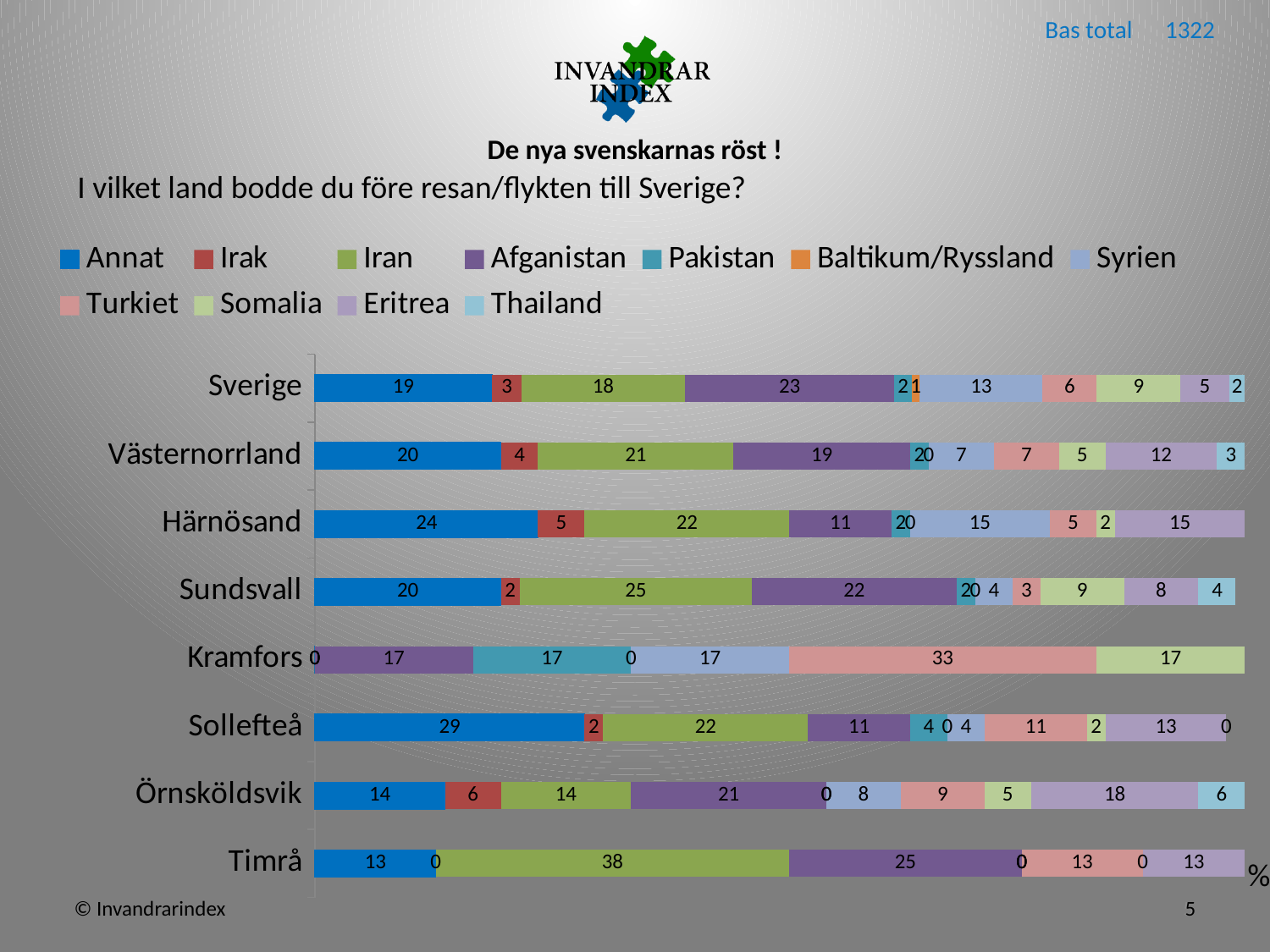
What question is the chart about, as stated above the legend? I vilket land bodde du före resan/flykten till Sverige? What is the difference between the Iran value for Timrå and the Iran value for Härnösand? 16 What is the value for Iran in the Timrå bar? 38 What is the value for Eritrea in the Örnsköldsvik bar? 18 How many categories (regions) are shown on the y axis? 8 What is the value for Annat in the Sollefteå bar? 29 What is the value for Afganistan in the Sverige bar? 23 What is the value for Turkiet in the Kramfors bar? 33 How many series does the legend list? 11 Which is larger in the Sundsvall bar, Iran or Afganistan? Iran Which region has the highest value for Annat? Sollefteå What type of chart is shown on the slide? Stacked bar chart